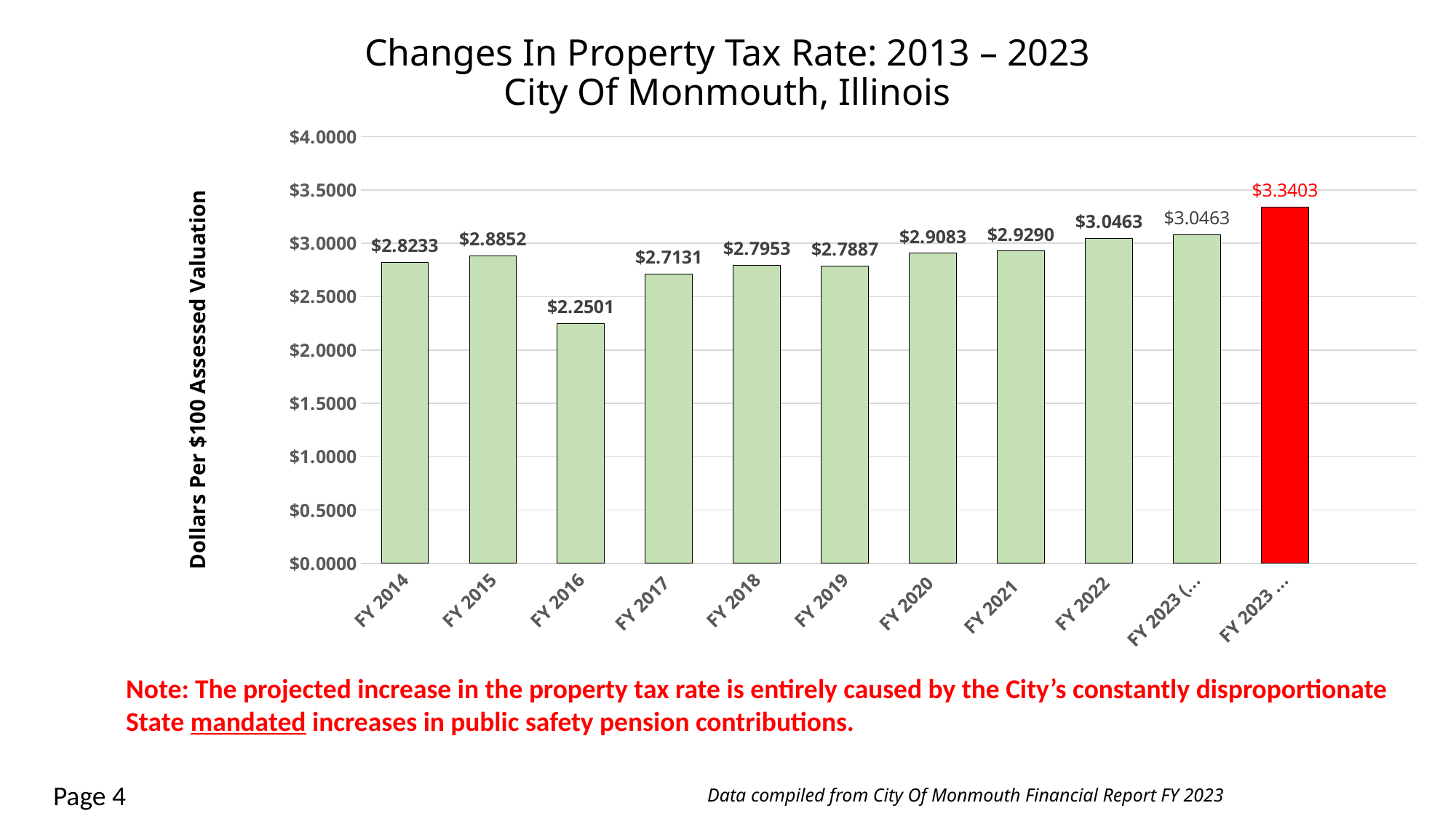
How many bars are plotted in the chart? 11 What is the difference between the FY 2015 and FY 2016 property tax rates? $0.6351 What is the property tax rate for FY 2014? $2.8233 What is the label on the vertical axis of the chart? Dollars Per $100 Assessed Valuation Which is larger, the property tax rate for FY 2018 or FY 2019? FY 2018 What is the property tax rate for FY 2016? $2.2501 What type of chart is shown on the slide? bar chart What is the property tax rate for FY 2020? $2.9083 What value is shown on the red bar at the far right of the chart? $3.3403 Is the value for FY 2022 greater or less than $3.0000? greater What is the difference between the FY 2022 rate and the value on the red bar? $0.2940 Which fiscal year has the lowest property tax rate? FY 2016